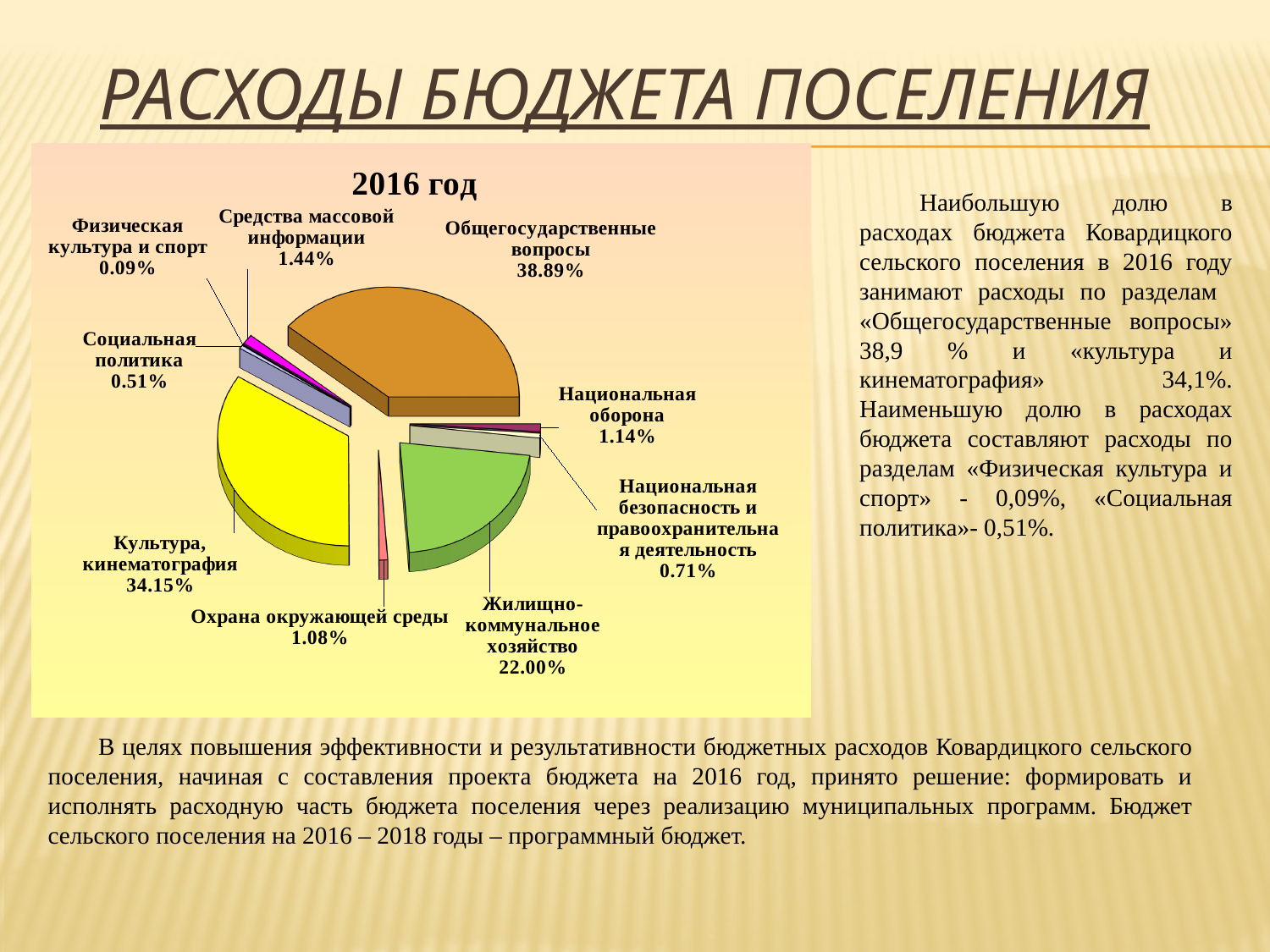
How many categories are shown in the pie chart? 9 What share of the pie does "Общегосударственные вопросы" take? 38.89% What is the value shown for "Культура, кинематография"? 34.15% What is the value shown for "Национальная оборона"? 1.14% What is the value shown for "Жилищно-коммунальное хозяйство"? 22.00% Which is larger: "Средства массовой информации" or "Охрана окружающей среды"? Средства массовой информации What is the title of the chart? 2016 год What is the difference between the shares of "Общегосударственные вопросы" and "Культура, кинематография"? 4.74% What is the value shown for "Социальная политика"? 0.51% Which category has the smallest share of the pie? Физическая культура и спорт What kind of chart is shown on the slide? Pie chart Which category has the largest share of the pie? Общегосударственные вопросы